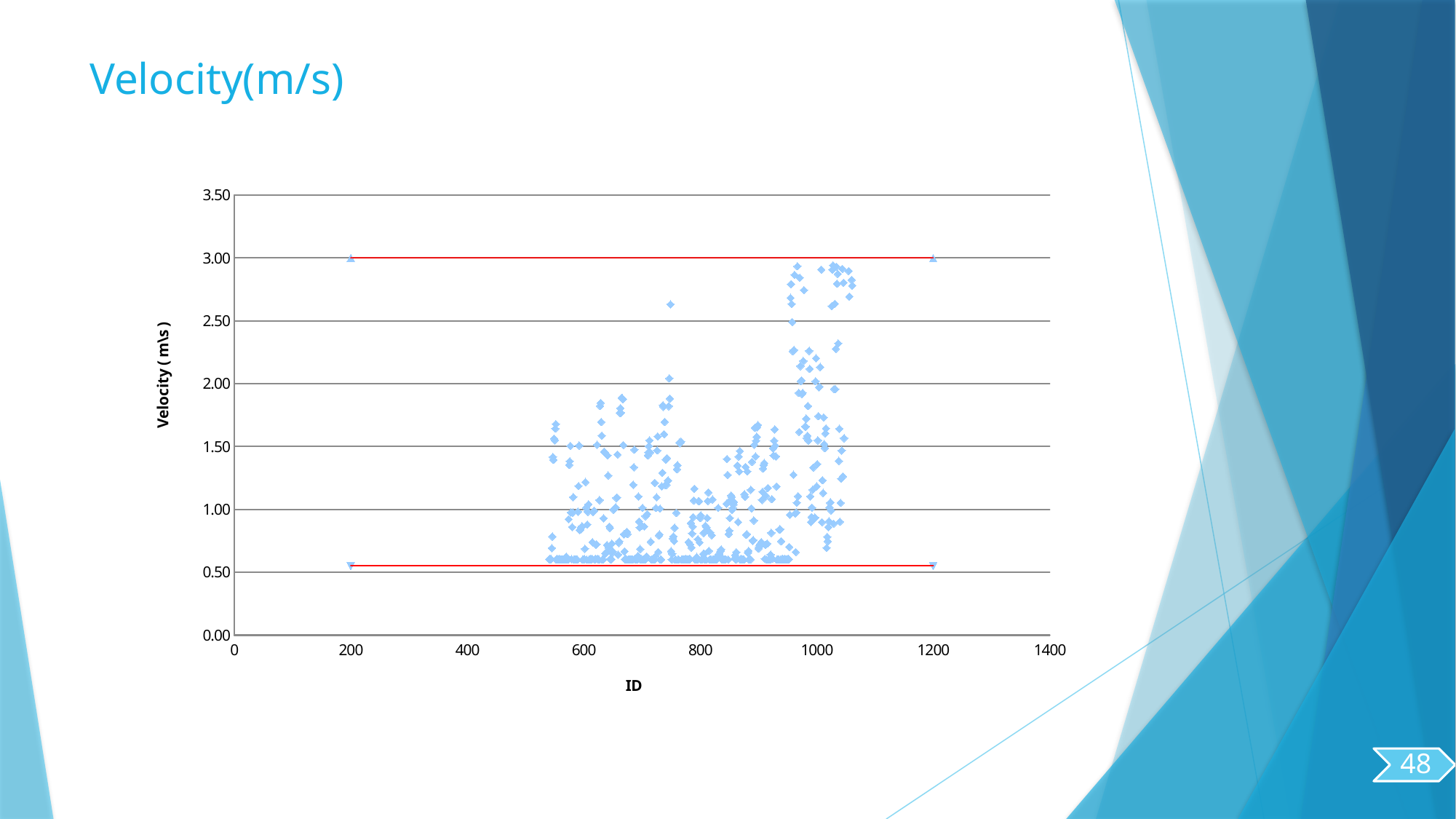
Is the highest scatter point greater or less than 3.50? less What is the highest value shown on the x axis? 1400 Is the scatter point near ID 750 that stands above the others greater or less than 2.50? greater At what velocity value does the upper red horizontal line sit? 3.00 Is the lower red horizontal line greater or less than 1.00? less Are the scatter points with the highest velocities found at IDs below 800 or above 800? above 800 What is the highest value shown on the y axis? 3.50 What kind of chart is shown on the slide? scatter chart What is the title of the chart on the slide? Velocity(m/s) What is the label of the x axis? ID